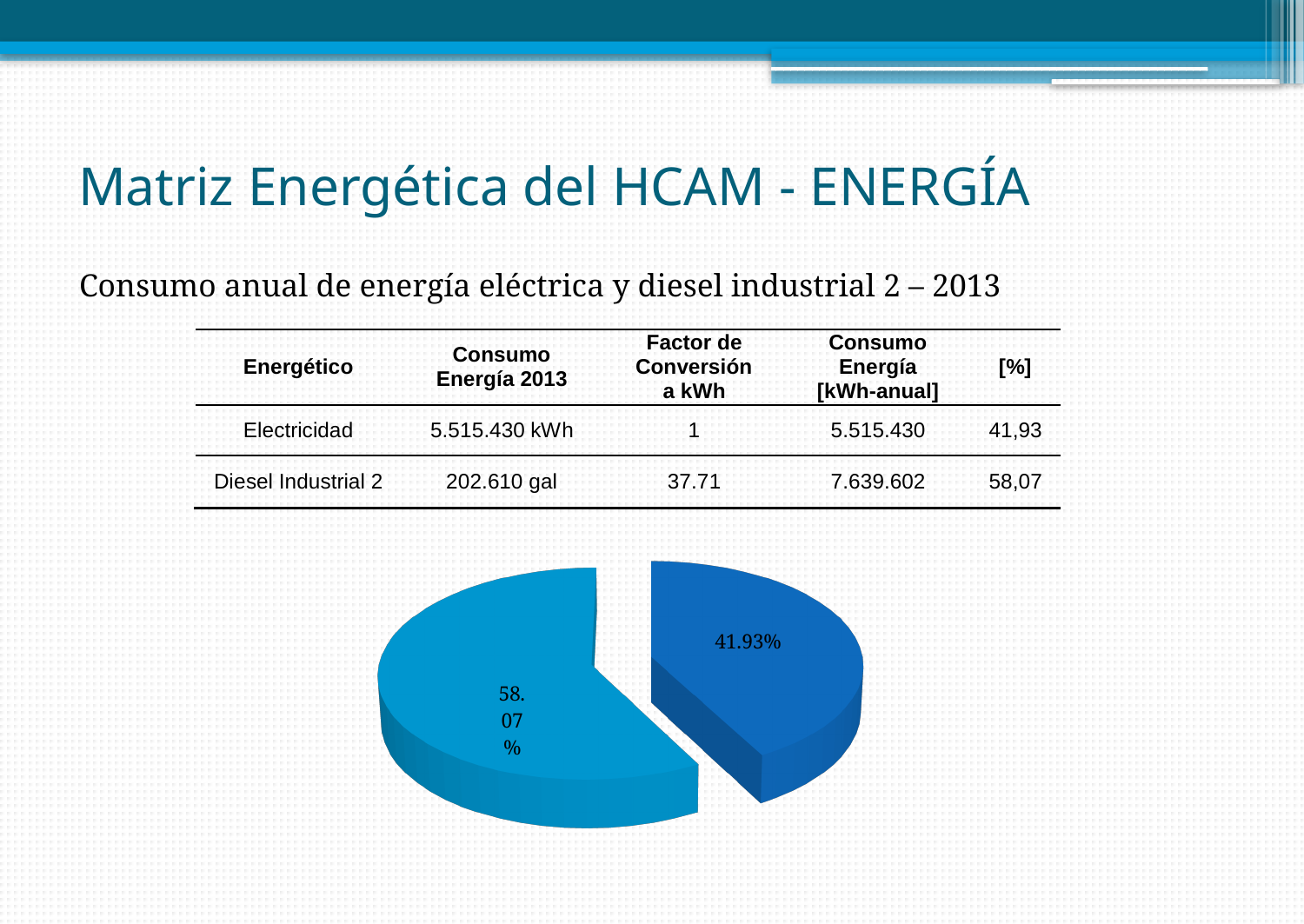
What share of the pie does the dark blue slice represent? 41.93% What is the value of the largest slice in the pie chart? 58.07% How many slices does the pie chart have? 2 What is the value of the smallest slice in the pie chart? 41.93% What percentage is shown on the dark blue slice of the pie chart? 41.93% Does the pie chart display a legend? No What kind of chart is shown on the slide? Pie chart Which slice is larger in the pie chart, the dark blue one or the light blue one? The light blue one Is the light blue slice of the pie chart greater or less than 50%? greater What is the difference in percentage points between the two slices of the pie chart? 16.14 What percentage is shown on the light blue slice of the pie chart? 58.07% Which slice of the pie chart is pulled out (exploded) from the rest? The 41.93% slice